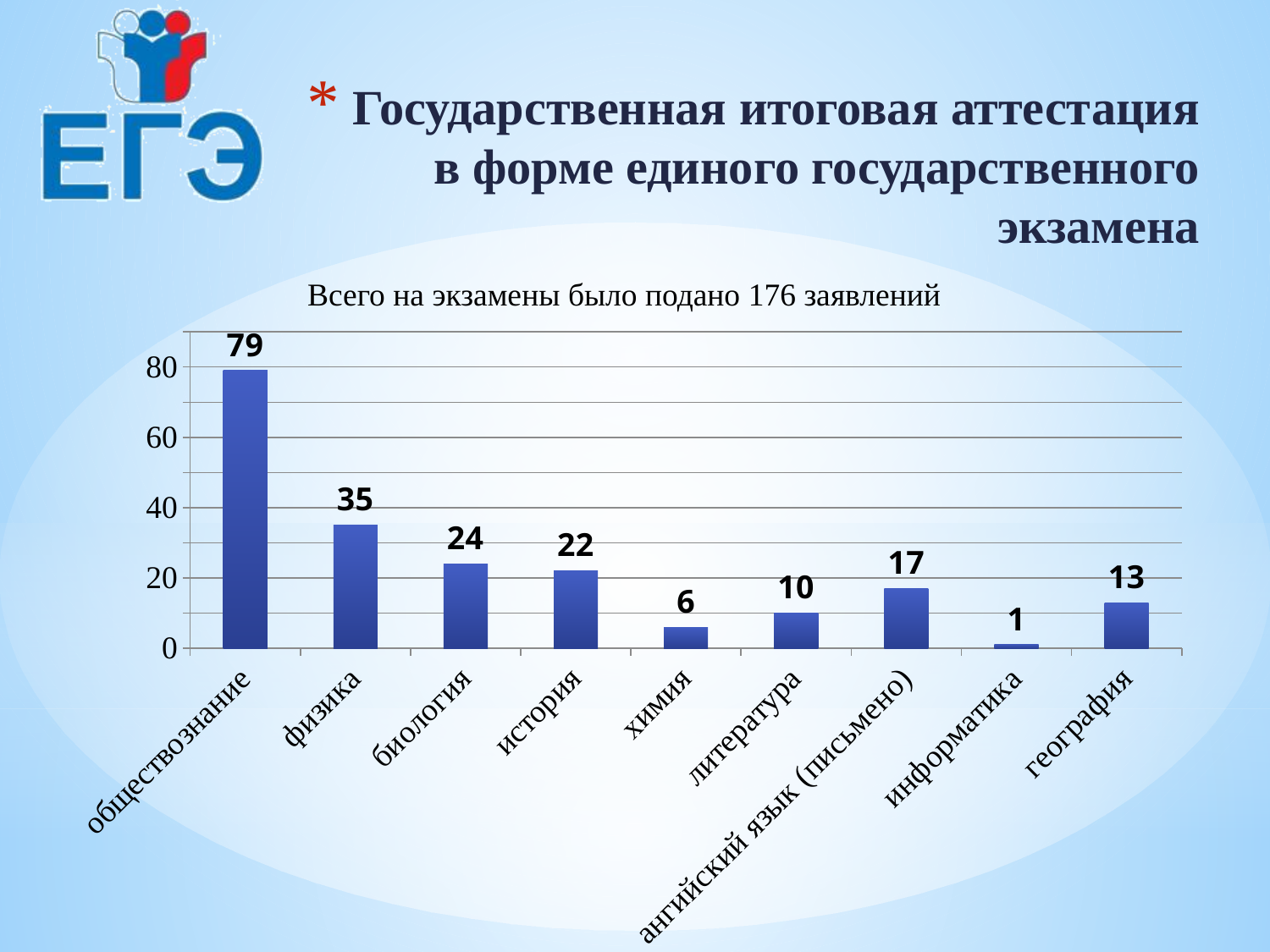
What is the difference between the values for физика and биология? 11 How many subjects are shown on the chart? 9 Which has a larger value, история or литература? история What is the title of the chart? Всего на экзамены было подано 176 заявлений Is the value for химия greater or less than 20? less Which subject has the lowest number of applications? информатика What is the value shown for английский язык (письмено)? 17 What is the value shown for физика? 35 Which subject has the highest number of applications? обществознание What is the value shown for география? 13 How many applications were submitted for обществознание? 79 What kind of chart is shown on the slide? bar chart